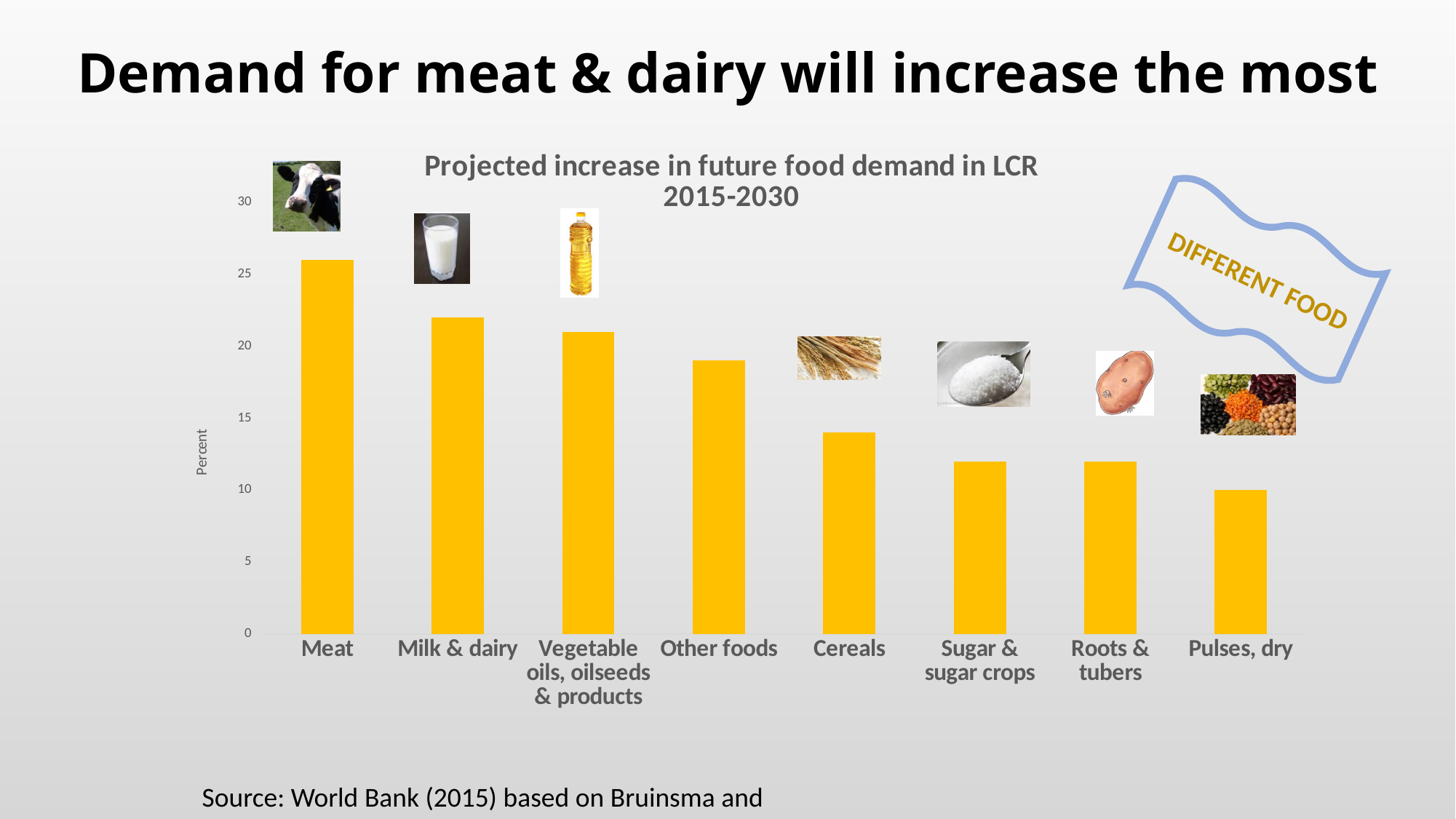
Is the value for Milk & dairy greater or less than 20? greater What kind of chart is shown on the slide? Bar chart What is the label on the vertical axis of the chart? Percent Is the value for Cereals greater or less than 15? less Is the value for Meat greater or less than 20? greater Which food category has the highest projected increase in demand? Meat How many food categories are shown on the x axis? 8 Do the bar values rise or fall moving from left to right along the x axis? Fall Which is larger, the value for Cereals or the value for Milk & dairy? Milk & dairy Which food category has the lowest projected increase in demand? Pulses, dry